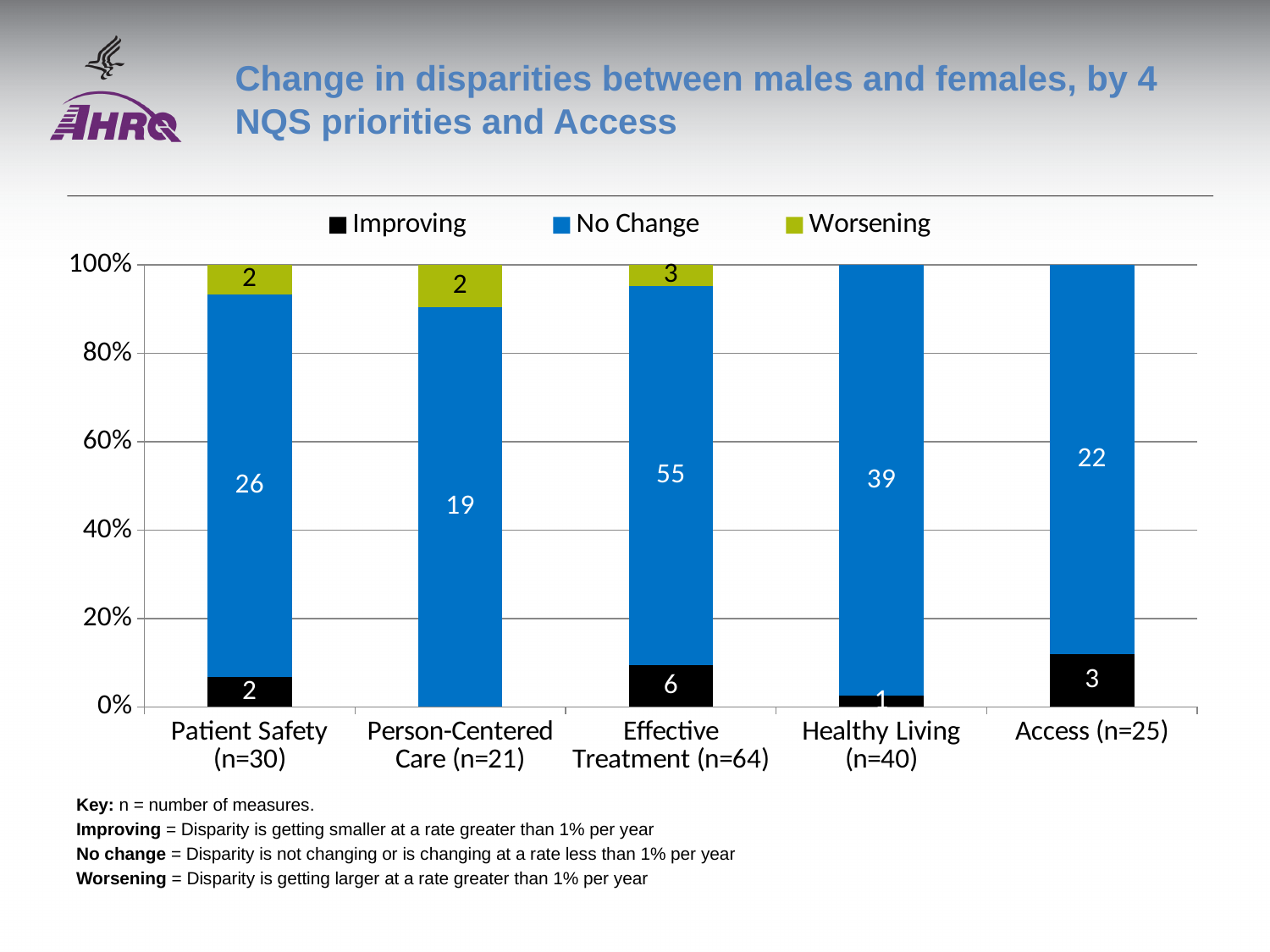
What is the No Change value for Healthy Living (n=40)? 39 How many categories are shown on the x axis? 5 What is the difference between the No Change values for Effective Treatment (n=64) and Healthy Living (n=40)? 16 What kind of chart is shown on the slide? Stacked bar chart Which category has the lowest Improving value among those with a printed Improving label? Healthy Living (n=40) Is the No Change share of the Access (n=25) bar greater or less than 80%? greater Which is larger, the Improving value for Effective Treatment (n=64) or the Improving value for Access (n=25)? Effective Treatment (n=64) How many series does the legend list? 3 What is the Worsening value for Person-Centered Care (n=21)? 2 What is the No Change value for Effective Treatment (n=64)? 55 Which category has the highest No Change value? Effective Treatment (n=64) What is the Improving value for Access (n=25)? 3